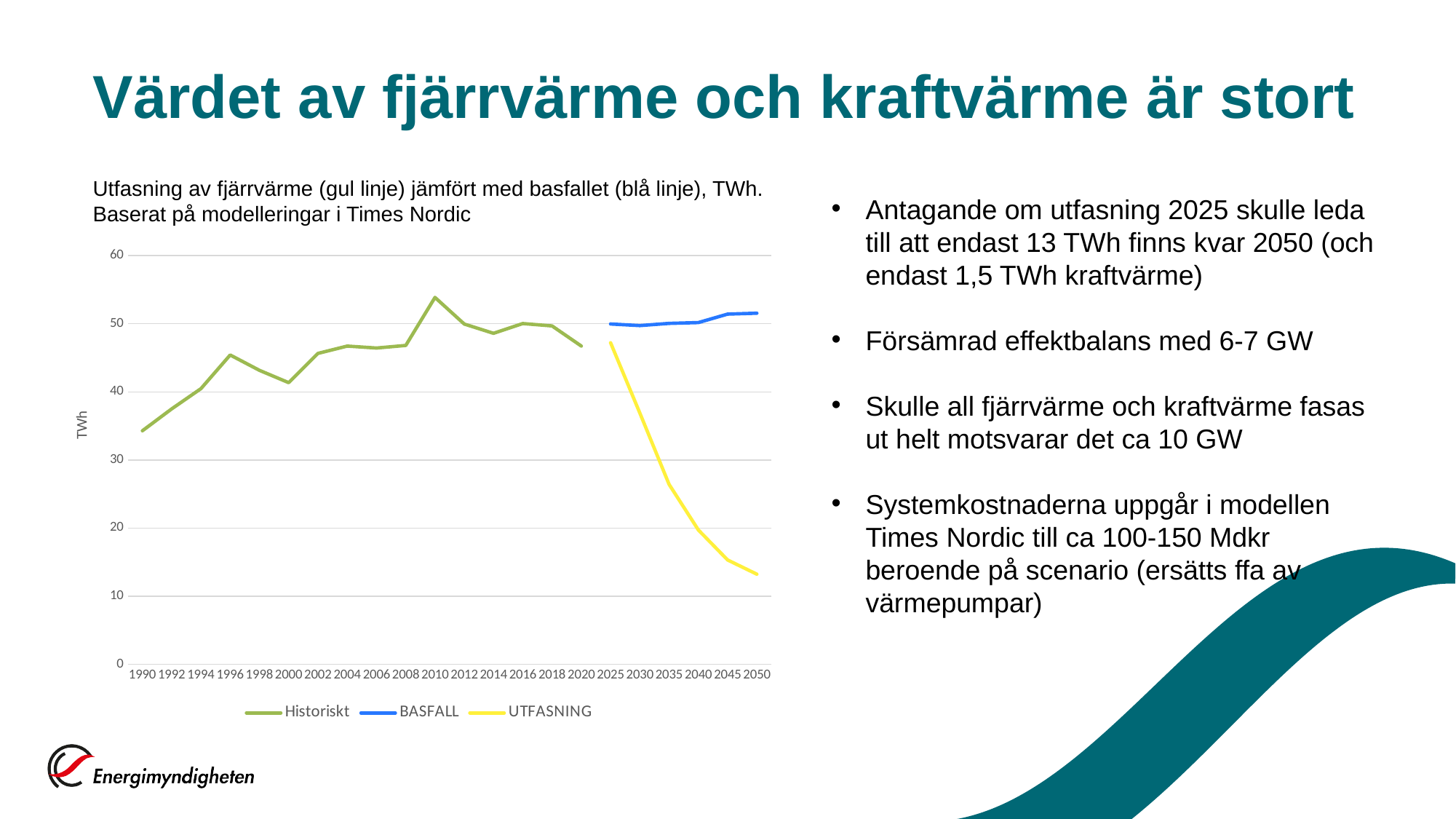
Is the UTFASNING value for 2050 greater or less than 20? less What is the label on the vertical axis of the chart? TWh How many series does the chart legend list? 3 In which year does the Historiskt series have its lowest value? 1990 Is the Historiskt value for 2010 greater or less than 50? greater What kind of chart is shown on the slide? line chart Is the BASFALL value for 2050 greater or less than 50? greater Does the UTFASNING line rise or fall from 2025 to 2050? fall In 2050, which series has the larger value, BASFALL or UTFASNING? BASFALL In which year does the Historiskt series reach its highest value? 2010 What are the three series named in the chart legend? Historiskt, BASFALL, UTFASNING